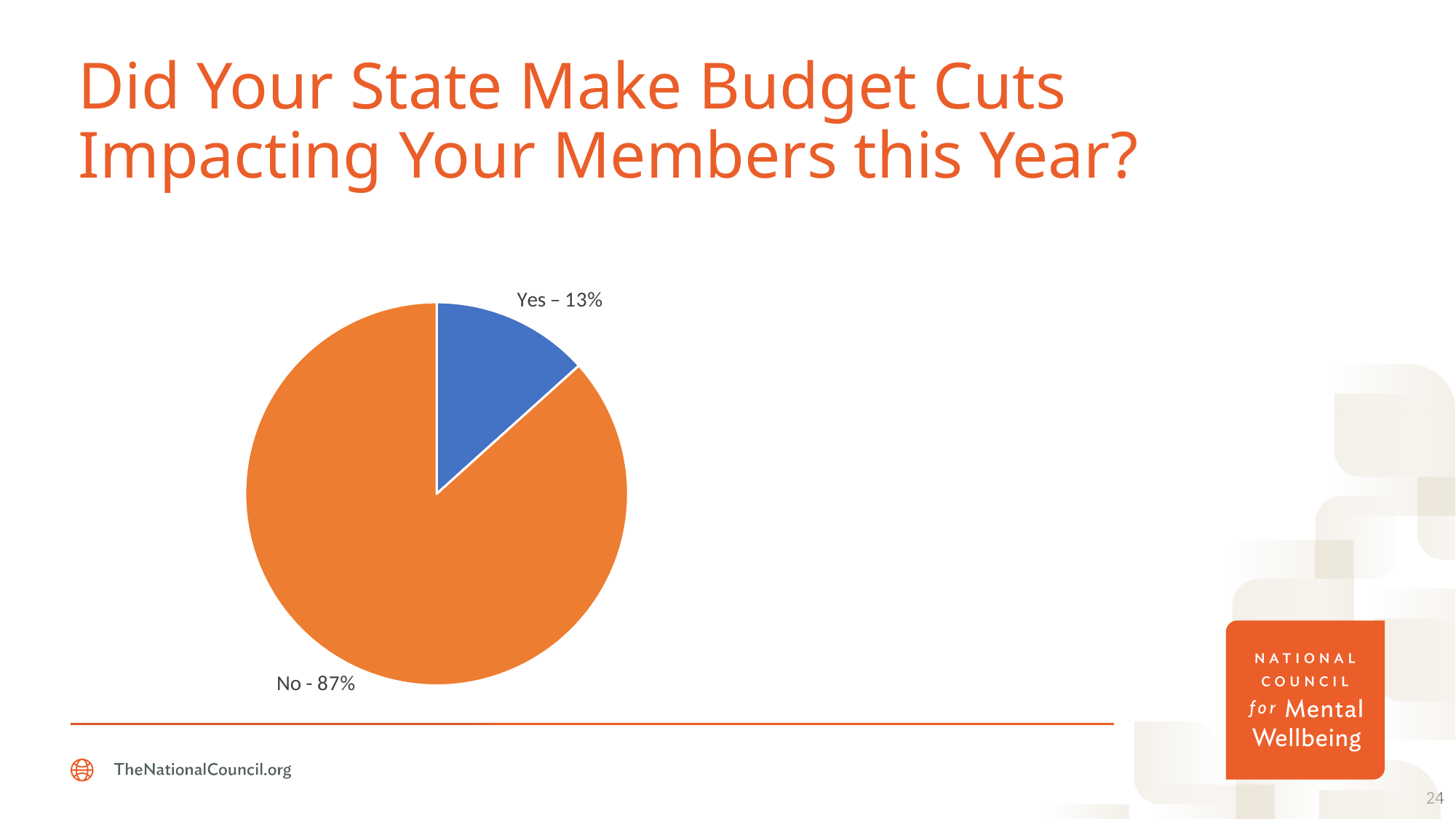
Is the share for "Yes" greater or less than 50%? less What share of the pie does the "No" slice represent? 87% What is the difference in percentage points between the "No" and "Yes" slices? 74 Which response has the smallest share of the pie? Yes What percentage of respondents answered "No"? 87% Which slice is larger, "Yes" or "No"? No What is the title of the slide containing the pie chart? Did Your State Make Budget Cuts Impacting Your Members this Year? What percentage of respondents answered "Yes"? 13% Which response has the largest share of the pie? No What kind of chart is shown on the slide? pie chart What colour is the "Yes" slice? blue How many slices does the pie chart have? 2